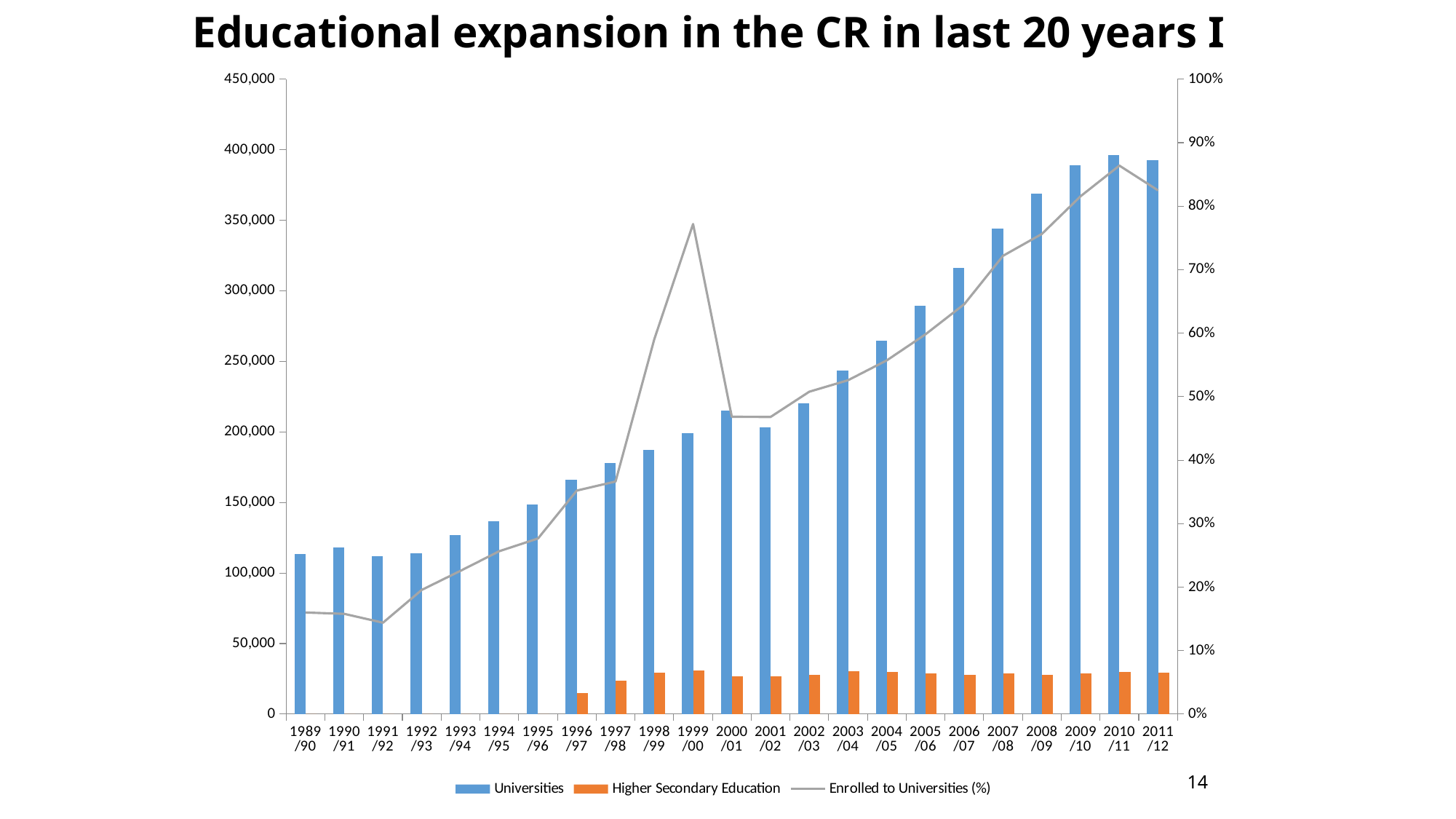
Which year has the highest Enrolled to Universities (%) value? 2010/11 In which academic year does the Higher Secondary Education series first appear? 1996/97 Do the Universities values generally rise or fall from 1989/90 to 2010/11? rise Is the Universities value for 2005/06 greater or less than 250,000? greater How many series does the legend list? 3 Is the Higher Secondary Education value for 1996/97 greater or less than 50,000? less Which year has the lowest Enrolled to Universities (%) value? 1991/92 What kind of chart is shown on the slide? bar chart with a line How many academic years are shown on the x axis? 23 Is the Enrolled to Universities (%) value for 1999/00 greater or less than 70%? greater Which is larger, the Universities value for 2008/09 or for 2009/10? 2009/10